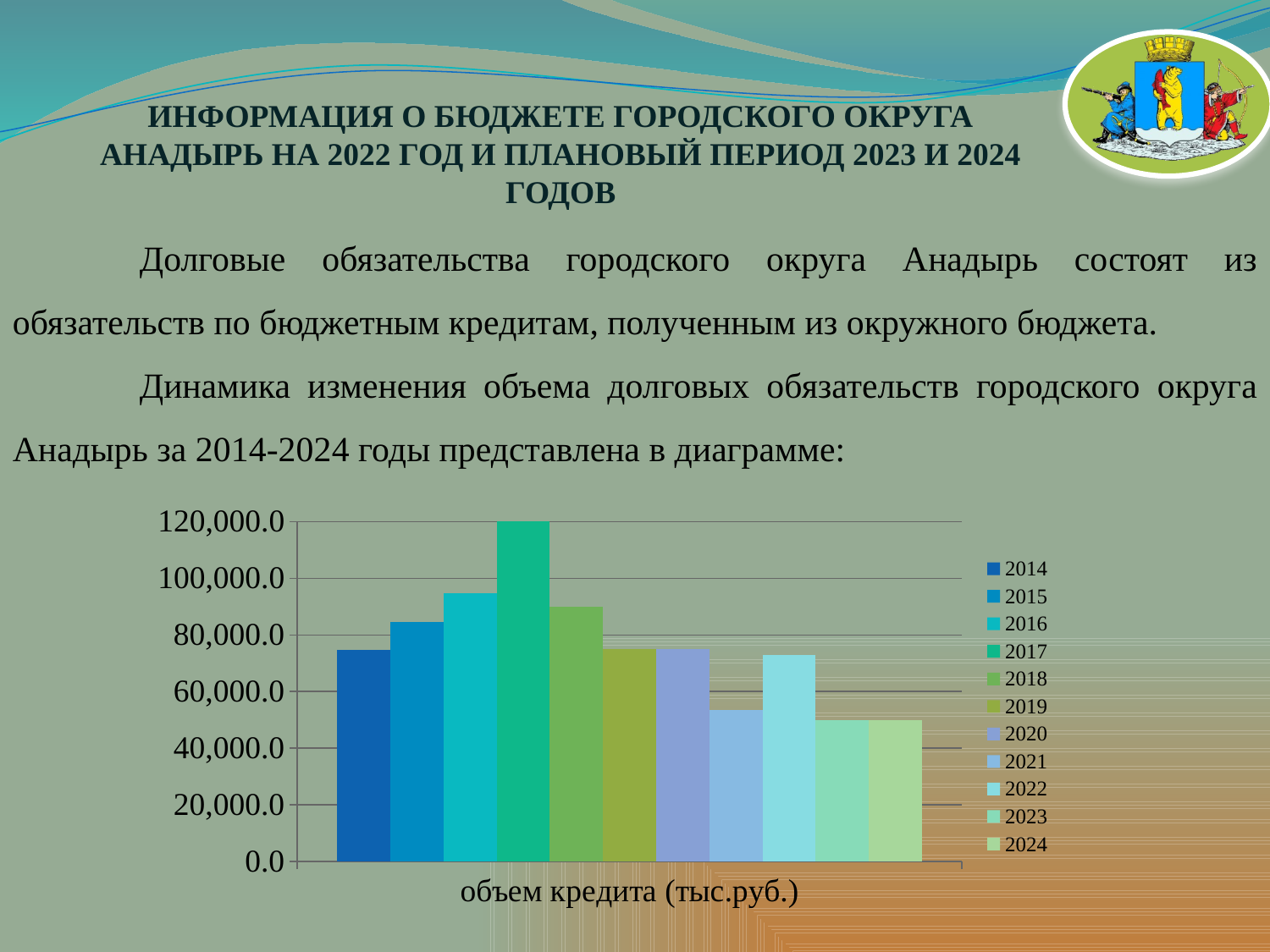
Which is larger, the value for 2021 or the value for 2022? 2022 Is the value for 2014 greater or less than 60,000.0? greater How many series does the legend list? 11 Is the value for 2016 greater or less than 100,000.0? less Is the value for 2023 greater or less than 60,000.0? less What is the label shown on the horizontal axis of the chart? объем кредита (тыс.руб.) What is the value for 2017 in the chart? 120,000.0 Which is larger, the value for 2015 or the value for 2016? 2016 What kind of chart is shown on the slide? bar chart Which year has the highest value in the chart? 2017